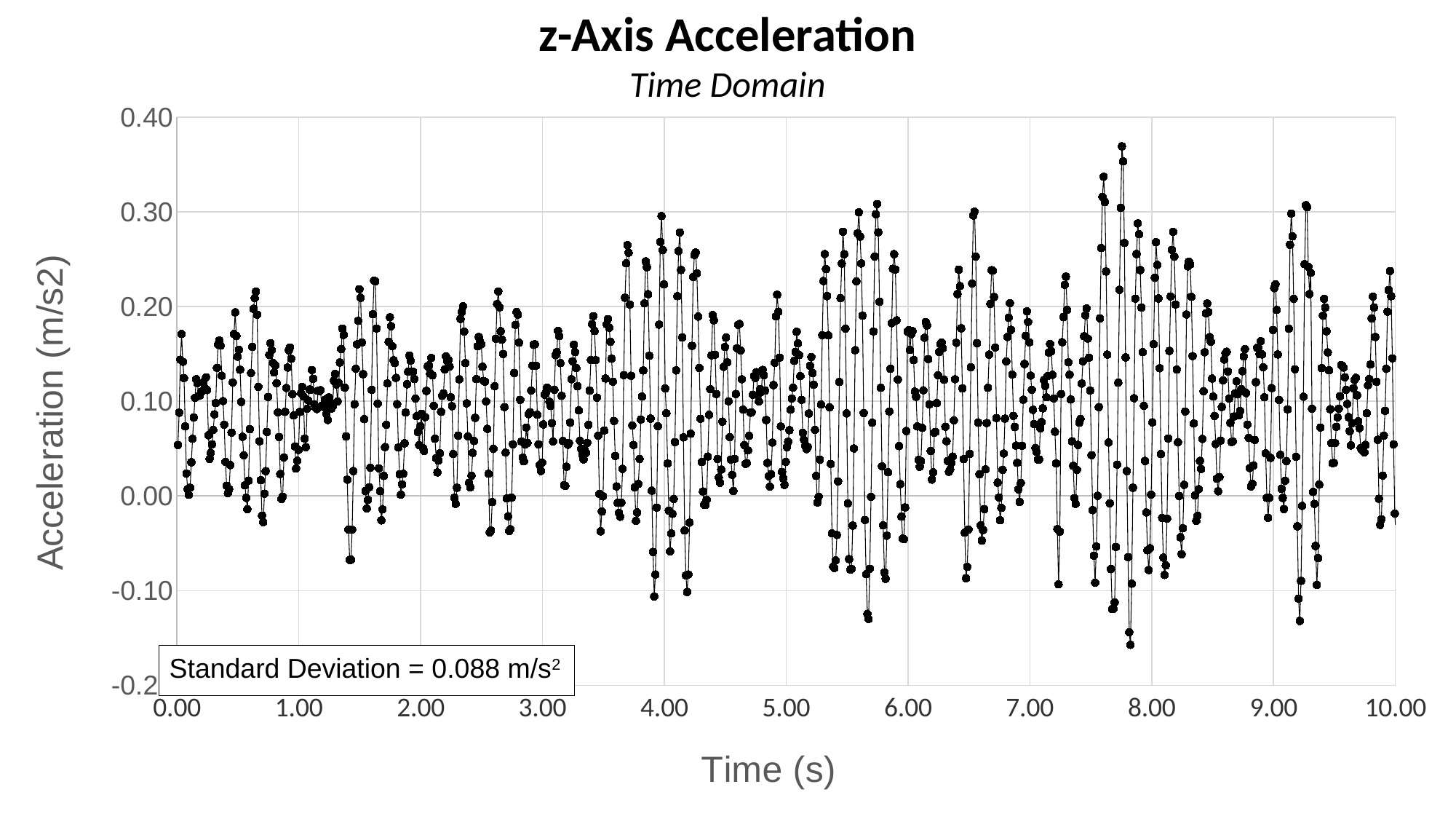
What standard deviation is printed on the chart? 0.088 m/s² Is the lowest plotted acceleration value greater or less than -0.2? greater What kind of chart is shown on the slide? line chart What is the title of the chart? z-Axis Acceleration What is the label of the x axis? Time (s) Is the lowest plotted acceleration value greater or less than -0.10? less Is the highest plotted acceleration value greater or less than 0.30? greater